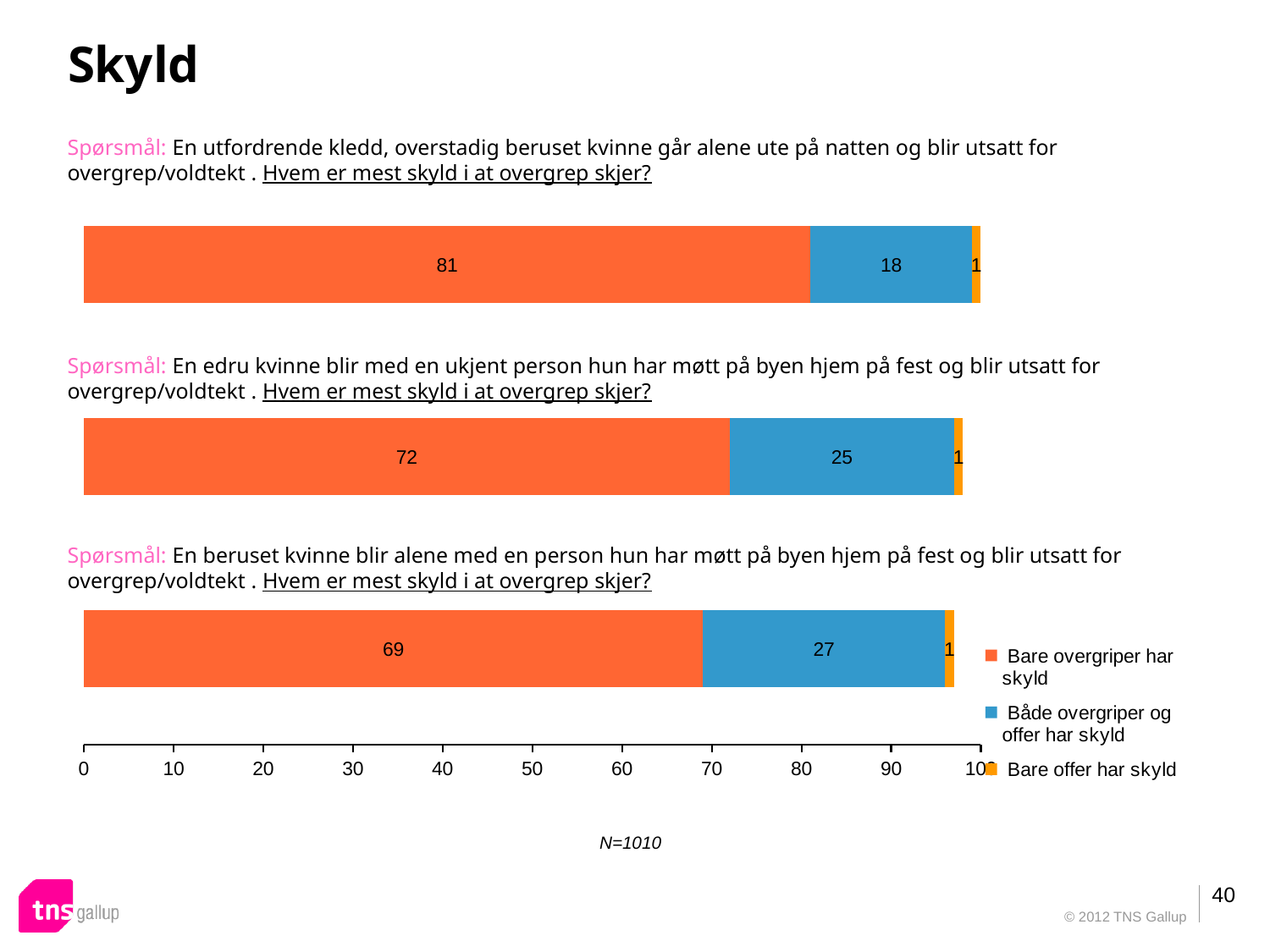
In the bottom chart, which series has the highest value? Bare overgriper har skyld In the top chart, what is the value for 'Bare overgriper har skyld'? 81 In the top chart, what is the difference between 'Bare overgriper har skyld' and 'Både overgriper og offer har skyld'? 63 What kind of chart is the bottom chart? Stacked bar chart In the bottom chart, what is the value for 'Bare offer har skyld'? 1 In the middle chart, what is the value for 'Både overgriper og offer har skyld'? 25 In the top chart, what is the value for 'Både overgriper og offer har skyld'? 18 How many series does the legend on the slide list? 3 In the middle chart, what is the value for 'Bare overgriper har skyld'? 72 Is the value for 'Bare overgriper har skyld' in the bottom chart greater or less than 60? greater In the middle chart, what is the total of the stacked bar? 98 In the bottom chart, what is the value for 'Både overgriper og offer har skyld'? 27